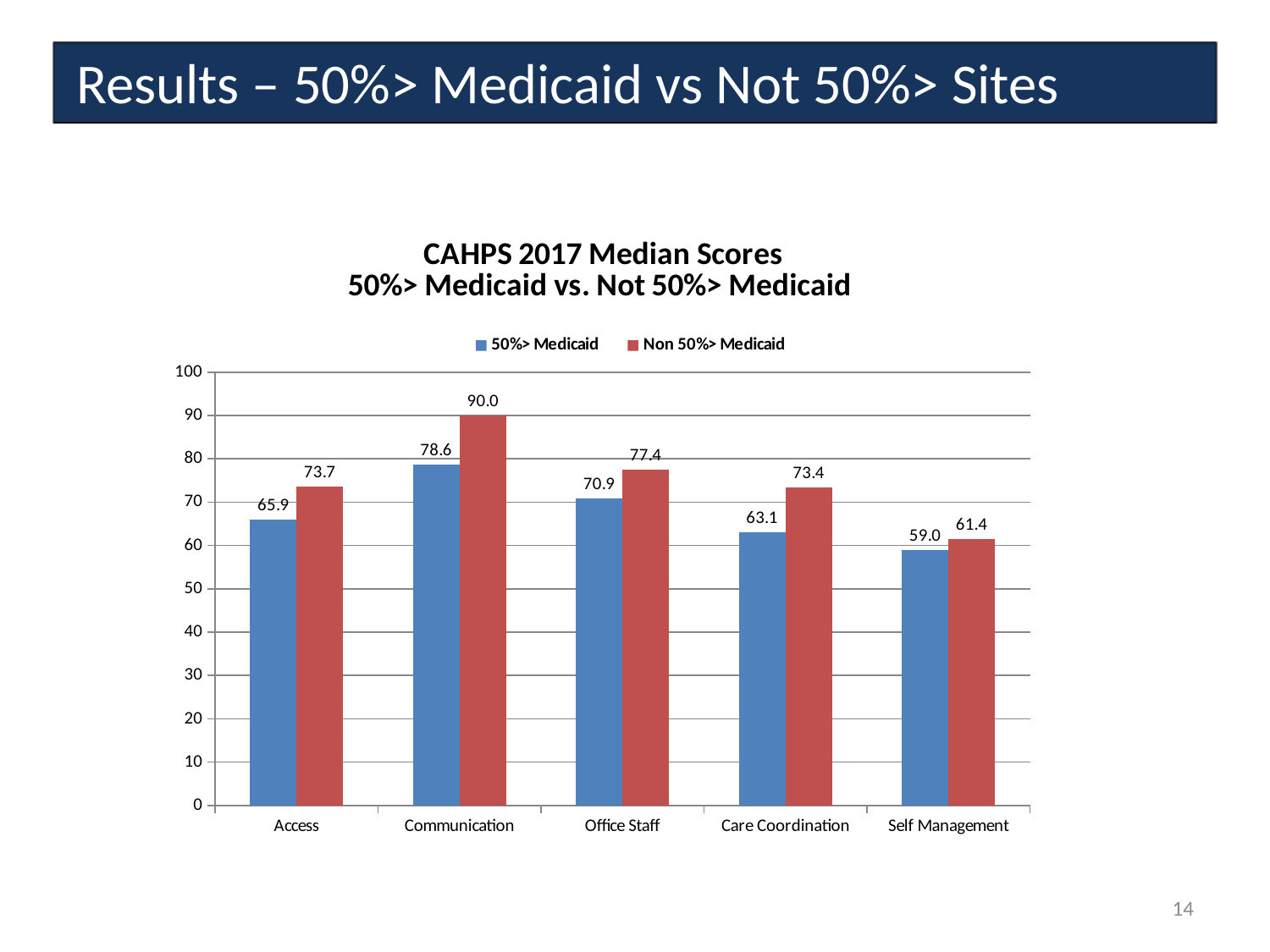
How many categories are shown on the x axis? 5 What is the 50%> Medicaid median score for Self Management? 59.0 What kind of chart is shown on the slide? Bar chart Which category has the highest Non 50%> Medicaid score? Communication Which category has the lowest 50%> Medicaid score? Self Management What is the difference between the Non 50%> Medicaid and 50%> Medicaid scores for Communication? 11.4 How many series does the legend list? 2 What is the Non 50%> Medicaid median score for Care Coordination? 73.4 What is the difference between the Non 50%> Medicaid and 50%> Medicaid scores for Access? 7.8 What is the 50%> Medicaid median score for Communication? 78.6 Which is larger for Office Staff: the 50%> Medicaid score or the Non 50%> Medicaid score? Non 50%> Medicaid What colour are the Non 50%> Medicaid bars? Red